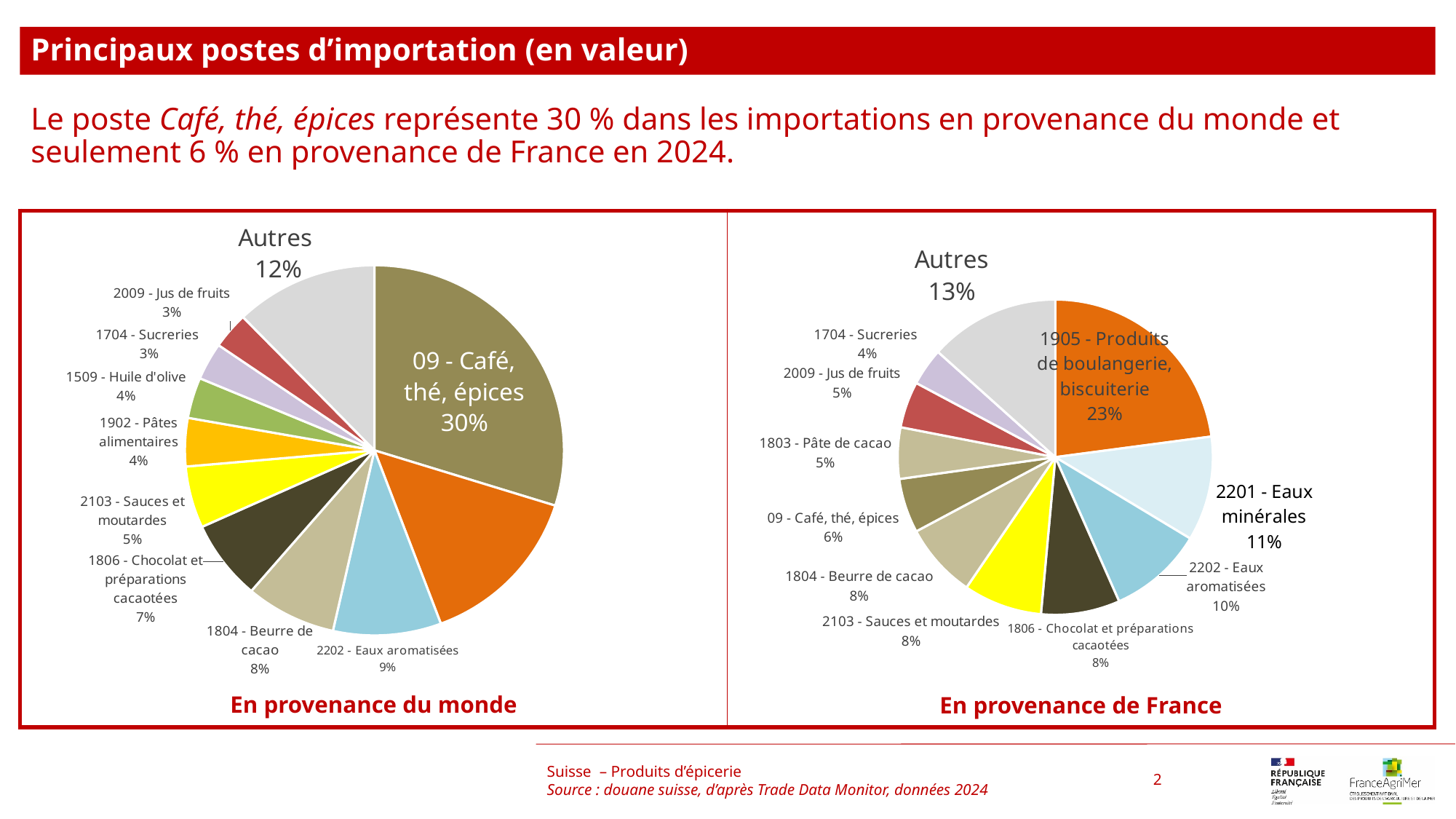
In the 'En provenance de France' pie chart, which is larger: '2201 - Eaux minérales' or '2202 - Eaux aromatisées'? 2201 - Eaux minérales In the 'En provenance de France' pie chart, which labelled category has the largest share? 1905 - Produits de boulangerie, biscuiterie In the 'En provenance de France' pie chart, which labelled category has the smallest share? 1704 - Sucreries In the 'En provenance du monde' pie chart, what is the share of '2202 - Eaux aromatisées'? 9% In the 'En provenance de France' pie chart, what share does '1905 - Produits de boulangerie, biscuiterie' represent? 23% In the 'En provenance du monde' pie chart, what is the difference between the share of '09 - Café, thé, épices' and the share of 'Autres'? 18 percentage points In the 'En provenance de France' pie chart, what is the share of '09 - Café, thé, épices'? 6% What type of chart is used on the slide for 'En provenance du monde'? Pie chart What is the title of the slide? Principaux postes d'importation (en valeur) In the 'En provenance du monde' pie chart, what share does '09 - Café, thé, épices' represent? 30% How many slices does the 'En provenance de France' pie chart have? 11 In the 'En provenance du monde' pie chart, what is the share of '1806 - Chocolat et préparations cacaotées'? 7%